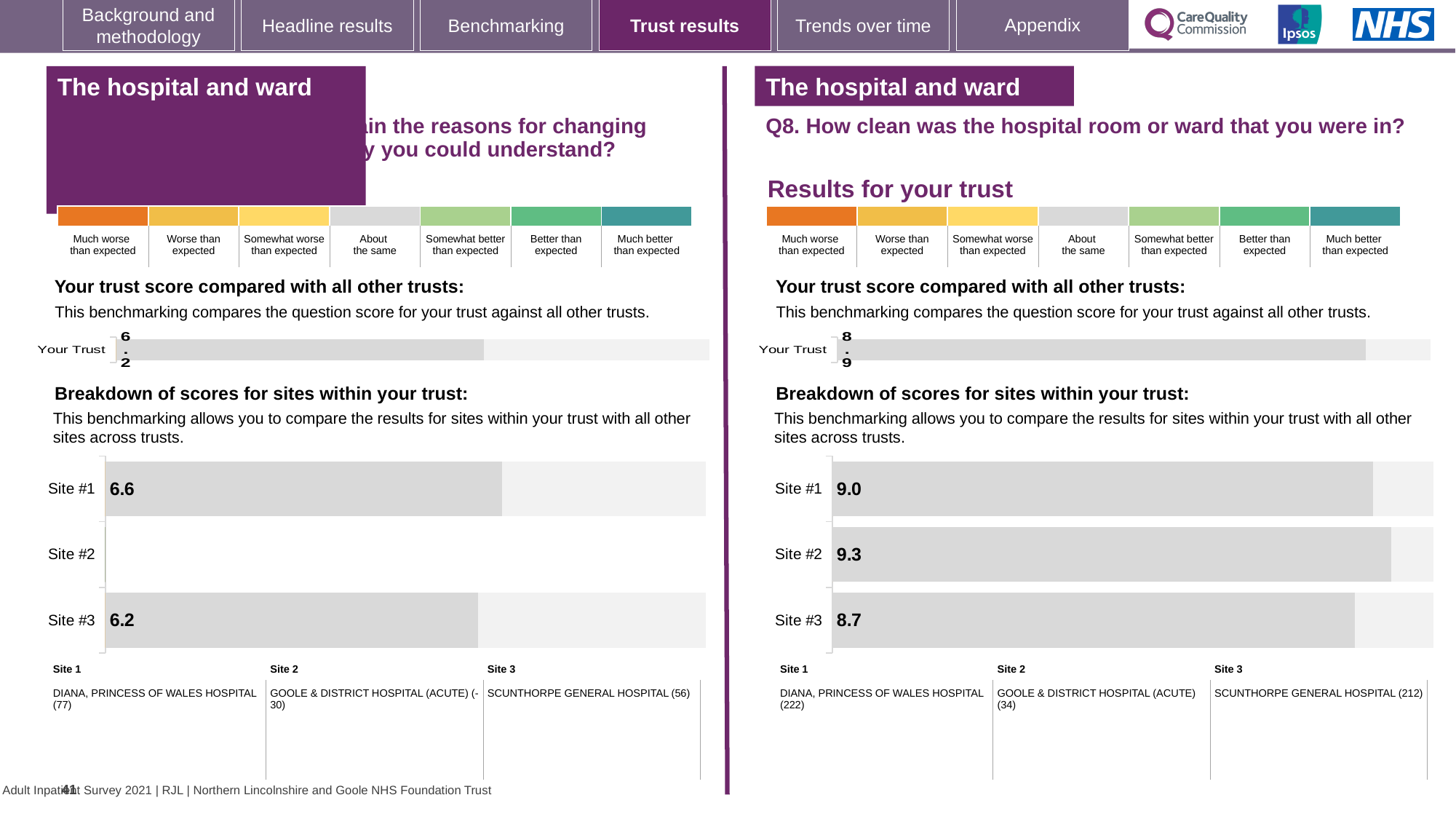
On the right-hand chart (Q8), what is the difference between the Site #2 score and the Site #3 score? 0.6 On the right-hand chart (Q8), which site has the lowest score? Site #3 On the right-hand chart (Q8), which site has the highest score? Site #2 On the left-hand site breakdown chart, what is the score for Site #3? 6.2 How many sites are listed on the right-hand site breakdown chart? 3 On the left-hand site breakdown chart, which is larger, the score for Site #1 or Site #3? Site #1 On the right-hand chart (Q8), what is the 'Your Trust' score? 8.9 On the left-hand site breakdown chart, what is the difference between the Site #1 and Site #3 scores? 0.4 On the right-hand chart (Q8, how clean was the hospital room or ward), what is the score for Site #2? 9.3 On the left-hand site breakdown chart, what is the score for Site #1? 6.6 On the right-hand chart (Q8), what is the score for Site #3? 8.7 What type of chart is used for the site breakdown on the right-hand side of the slide? Bar chart